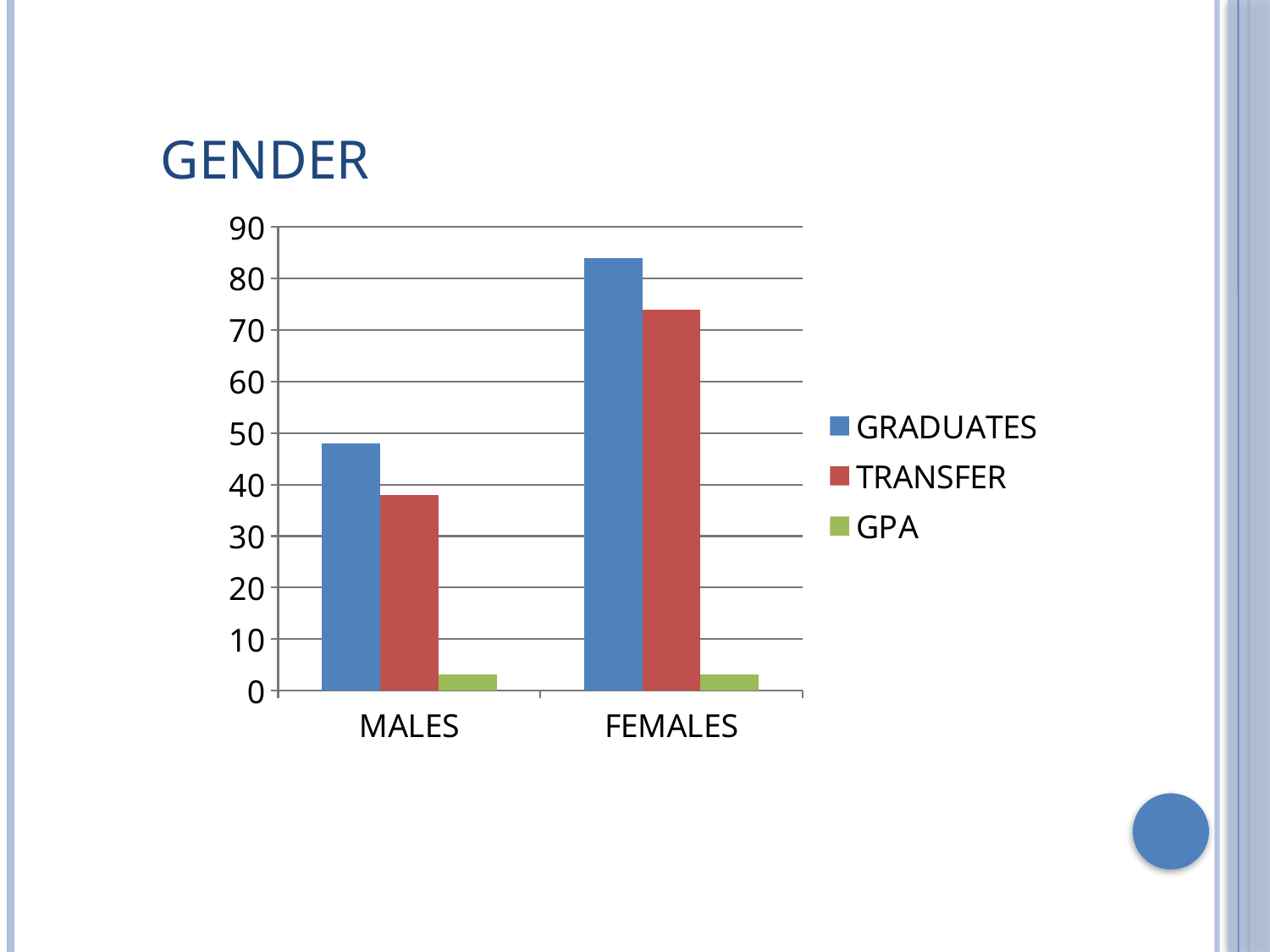
Which series has the lowest values for both MALES and FEMALES? GPA Which category has the higher GRADUATES value, MALES or FEMALES? FEMALES Is the TRANSFER value for FEMALES greater or less than 70? greater What kind of chart is shown on the slide? bar chart What is the title of the slide? GENDER Is the GRADUATES value for FEMALES greater or less than 80? greater Which category has the lower TRANSFER value? MALES Is the TRANSFER value for MALES greater or less than 40? less How many series does the legend list? 3 How many categories are shown on the x axis? 2 For FEMALES, which is larger, GRADUATES or TRANSFER? GRADUATES